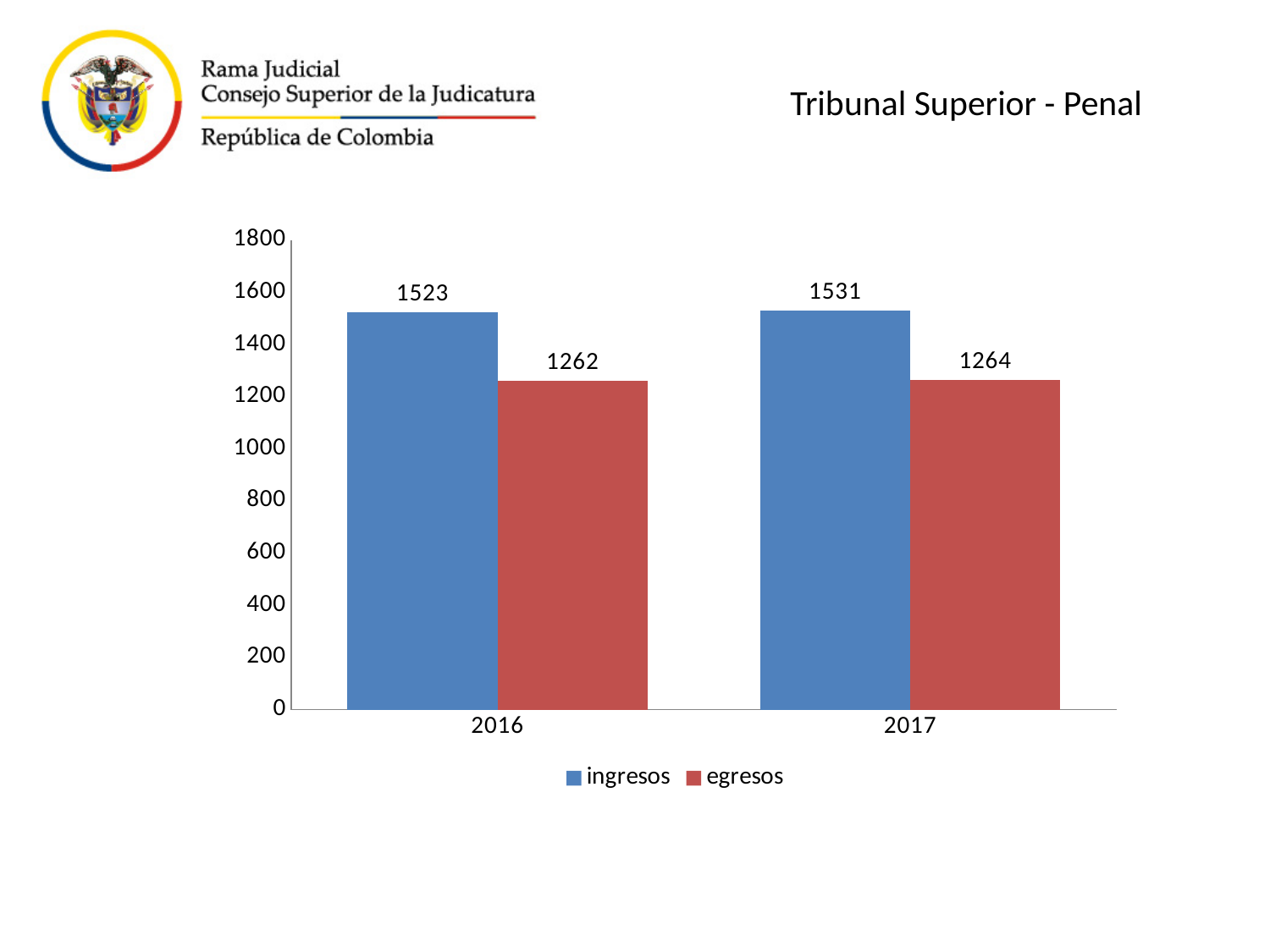
What is the value of egresos for 2016? 1262 What is the value of egresos for 2017? 1264 Is the value of egresos for 2016 greater or less than 1400? less What is the difference between ingresos and egresos in 2017? 267 What colour represents egresos in the chart? red Which is larger in 2017, ingresos or egresos? ingresos What is the value of ingresos for 2017? 1531 What kind of chart is shown on the slide? bar chart How many years are shown on the x axis? 2 How many series does the legend list? 2 What is the difference between ingresos and egresos in 2016? 261 What is the value of ingresos for 2016? 1523